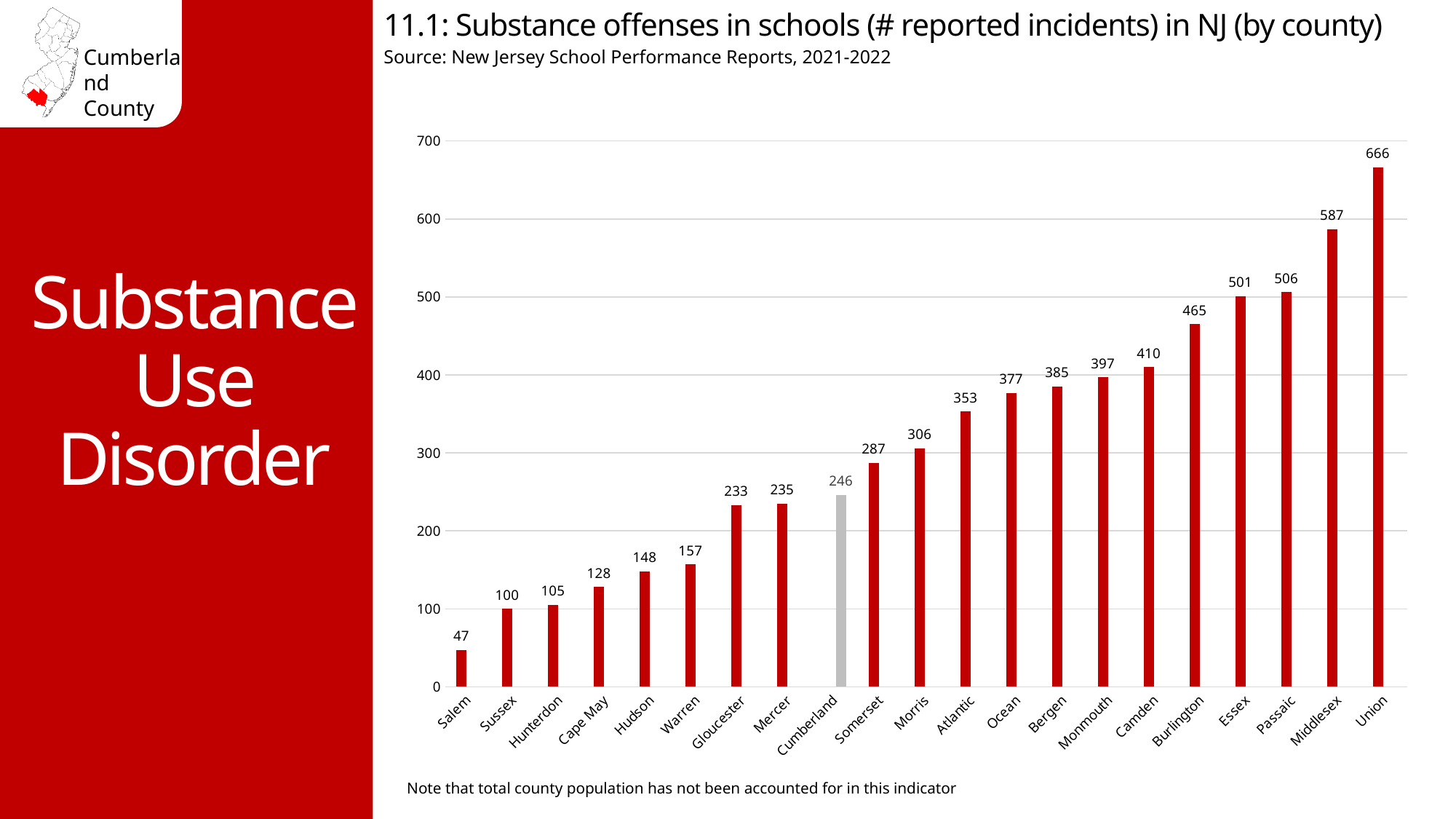
Do the values rise or fall moving from left to right along the x axis? rise What is the number of reported substance offense incidents in schools for Cumberland County? 246 Which has a higher value, Camden or Bergen? Camden What is the difference between the values for Union and Middlesex? 79 Which county's bar is coloured grey instead of red? Cumberland How many counties are shown on the chart? 21 Which county has the lowest number of reported incidents? Salem Is the value for Burlington greater or less than 500? less What is the difference between the values for Cumberland and Salem? 199 Which county has the highest number of reported incidents? Union What is the value shown for Gloucester? 233 What kind of chart is this? bar chart